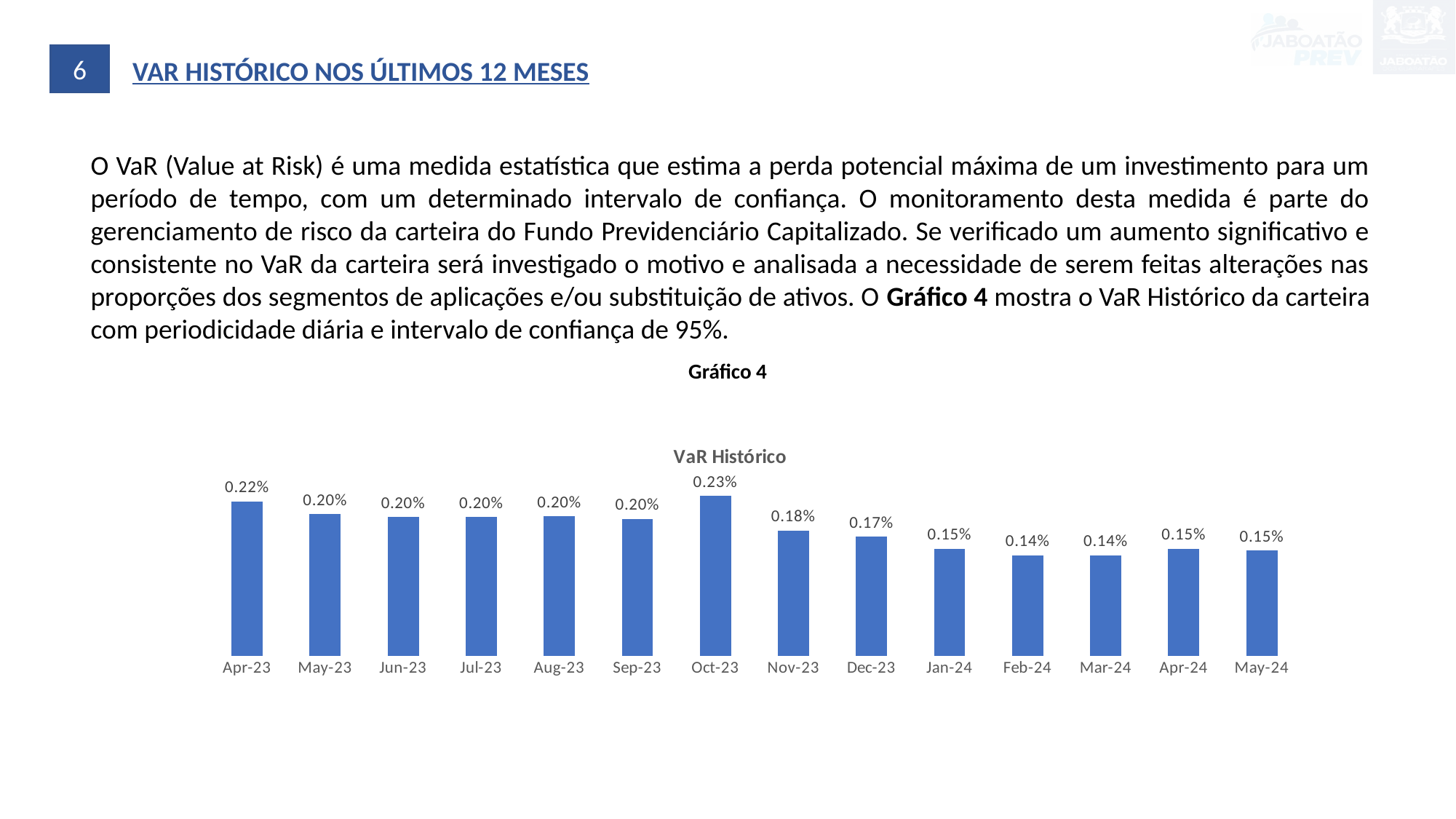
What kind of chart is the VaR Histórico chart? Bar chart Do the VaR Histórico values generally rise or fall from Apr-23 to May-24? Fall Which is larger, the VaR Histórico value for Apr-23 or for Jan-24? Apr-23 What is the VaR Histórico value for Feb-24? 0.14% What is the VaR Histórico value for Apr-23? 0.22% What is the difference between the VaR Histórico values for Apr-23 and May-24? 0.07% How many months are shown on the VaR Histórico chart? 14 Which month has the highest VaR Histórico value? Oct-23 Which is larger, the VaR Histórico value for Nov-23 or for Mar-24? Nov-23 What is the difference between the VaR Histórico values for Oct-23 and Nov-23? 0.05% What is the VaR Histórico value for Dec-23? 0.17% What is the VaR Histórico value for Oct-23? 0.23%